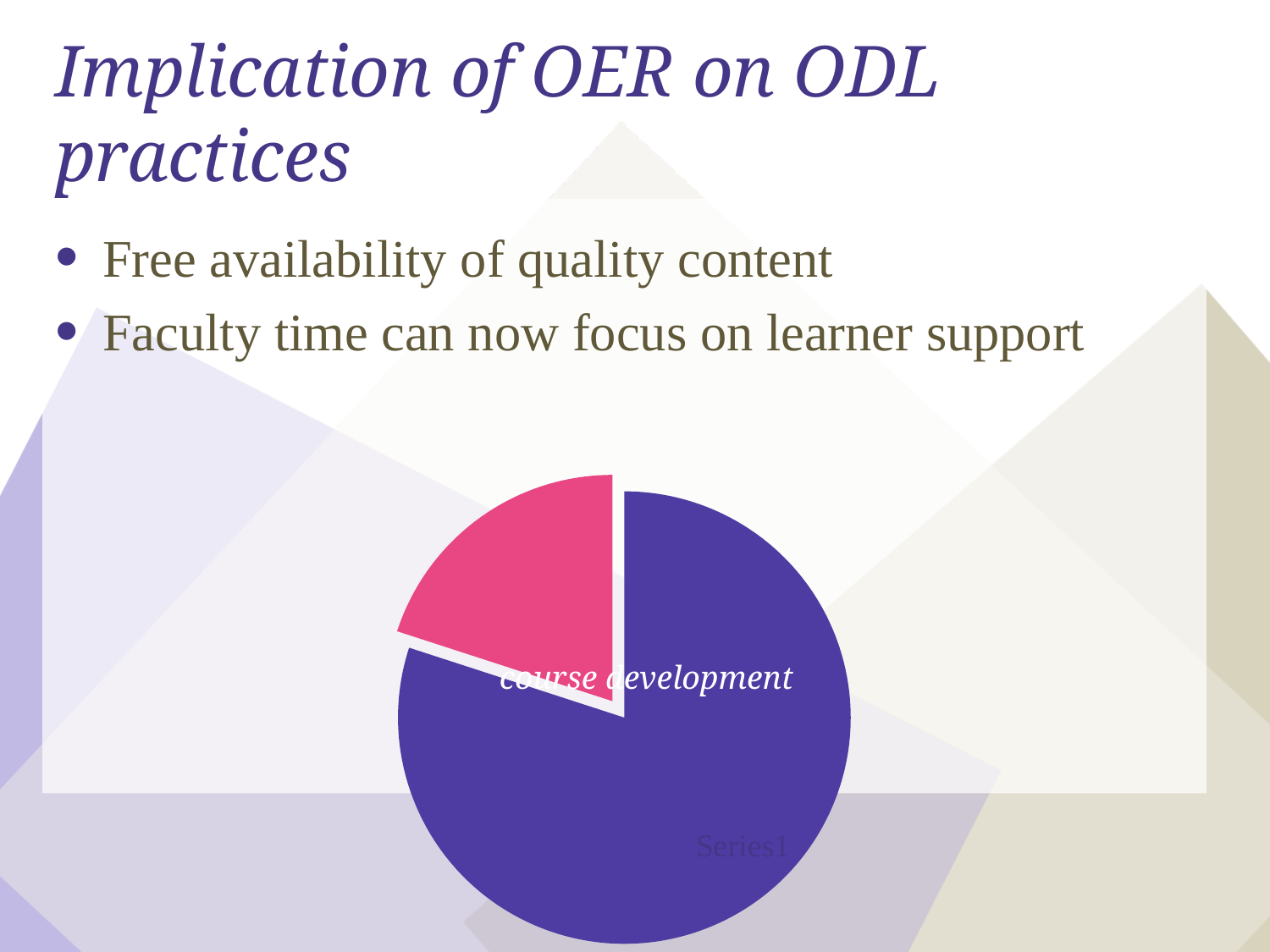
What text label is printed across the pie chart? course development Which slice of the pie chart is larger, the purple one or the pink one? the purple one What kind of chart is shown on the slide? pie chart What series name is printed near the bottom right of the pie chart? Series1 How many slices does the pie chart have? 2 Which colour is the smallest slice of the pie chart? pink Which colour is the largest slice of the pie chart? purple